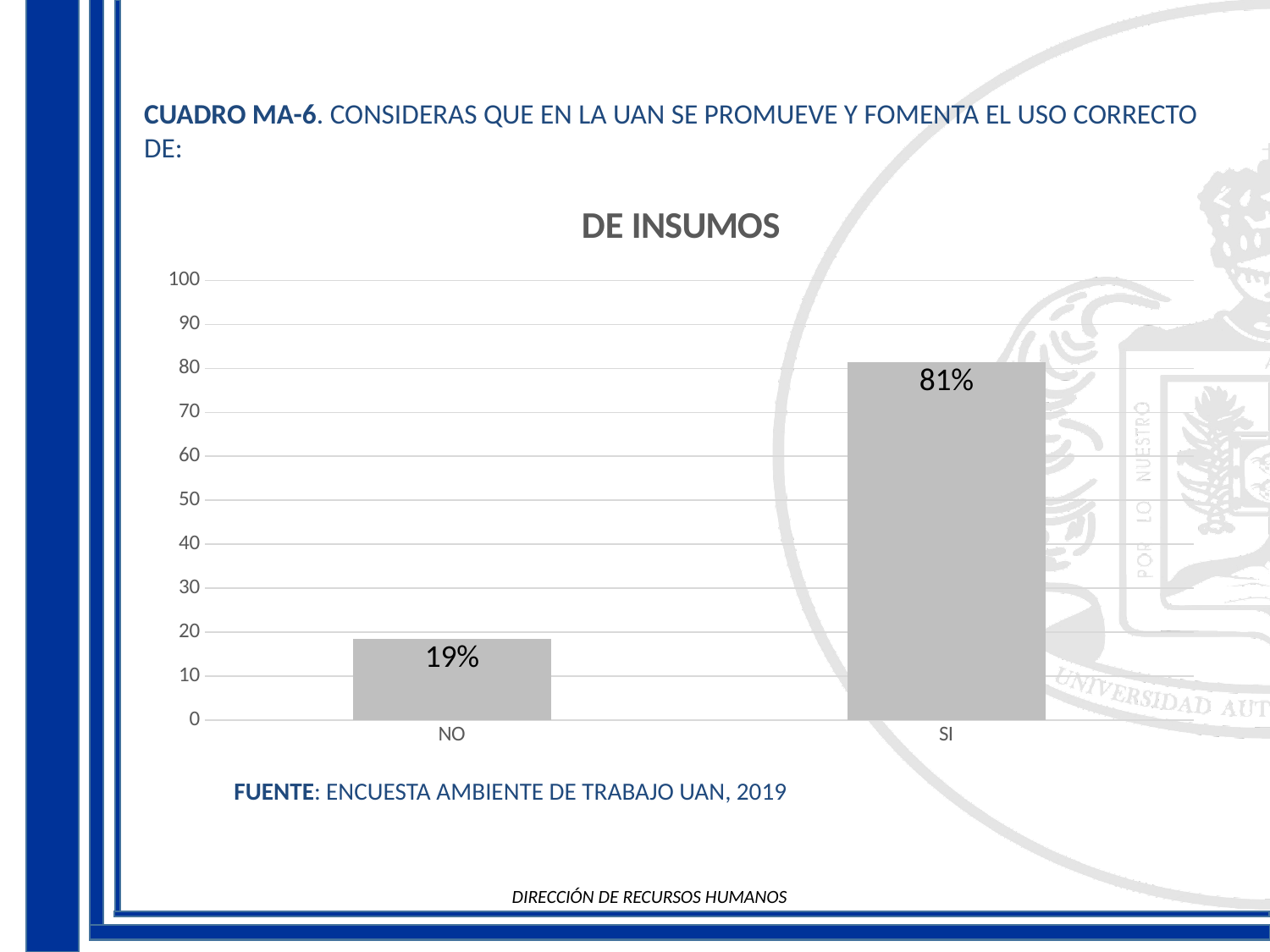
What is the title of the chart? DE INSUMOS What kind of chart is shown on the slide? bar chart Which category has the lowest value? NO Which is larger, the value for NO or the value for SI? SI What is the value for SI? 81% Is the value for NO greater or less than 30? less How many categories are shown on the x axis? 2 What is the difference between the values for SI and NO? 62% What is the value for NO? 19% Which category has the highest value? SI Is the value for SI greater or less than 70? greater What is the highest value shown on the y axis? 100